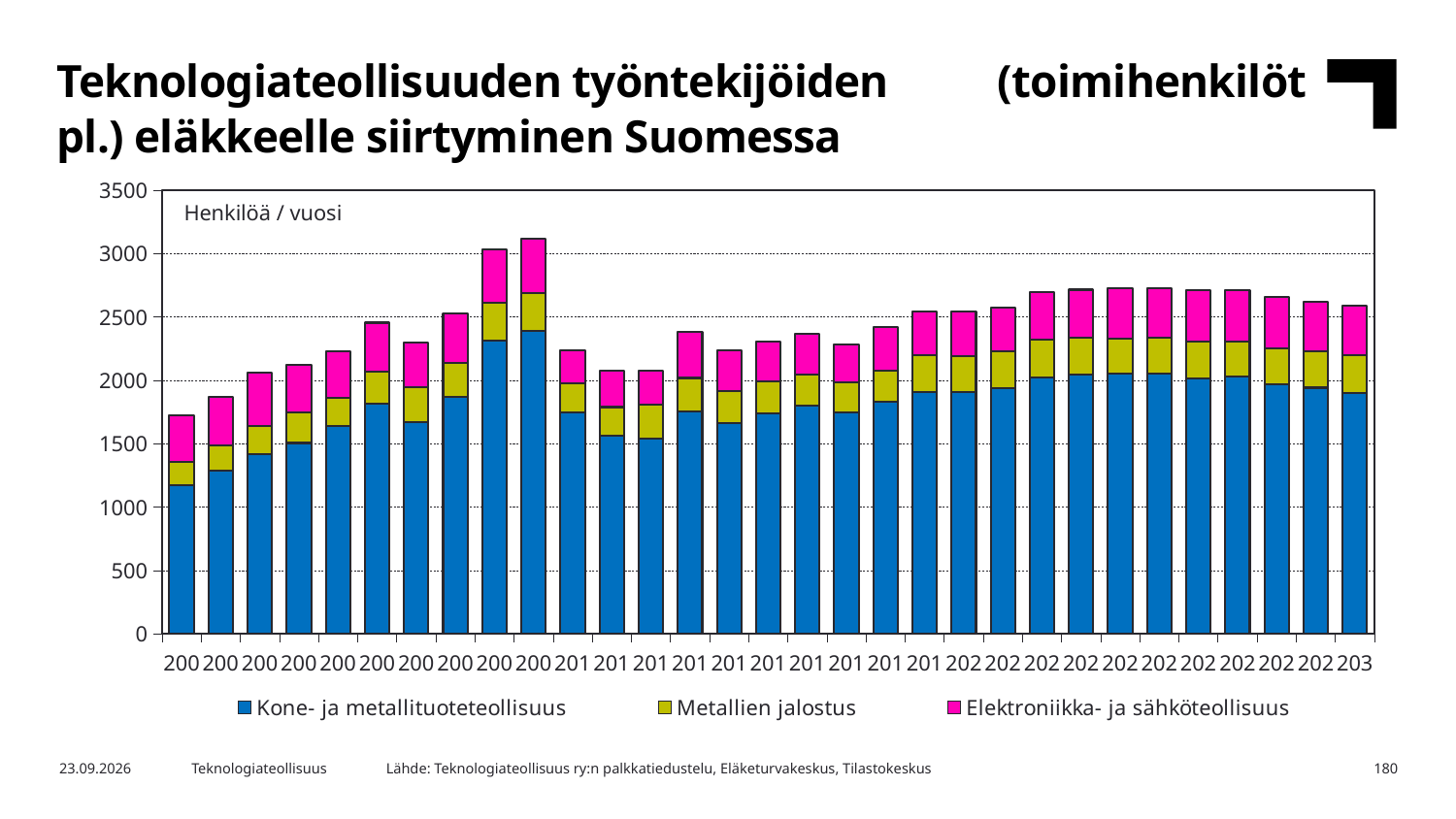
Is the total of the rightmost bar greater or less than 2500? greater Which series forms the largest segment in every bar? Kone- ja metallituoteteollisuus What unit label is printed inside the plot area at the top left? Henkilöä / vuosi How many series does the legend list? 3 What kind of chart is shown on the slide? Stacked bar chart How many bars (years) are plotted in the chart? 31 Which bar has the smallest total, the leftmost bar or the rightmost bar? The leftmost bar Is the Kone- ja metallituoteteollisuus segment of the leftmost bar greater or less than 1000? greater Comparing the leftmost bar with the rightmost bar, does the total rise or fall over the period? Rise Is the total of the tallest bar greater or less than 3000? greater Which series is shown in blue in the legend? Kone- ja metallituoteteollisuus